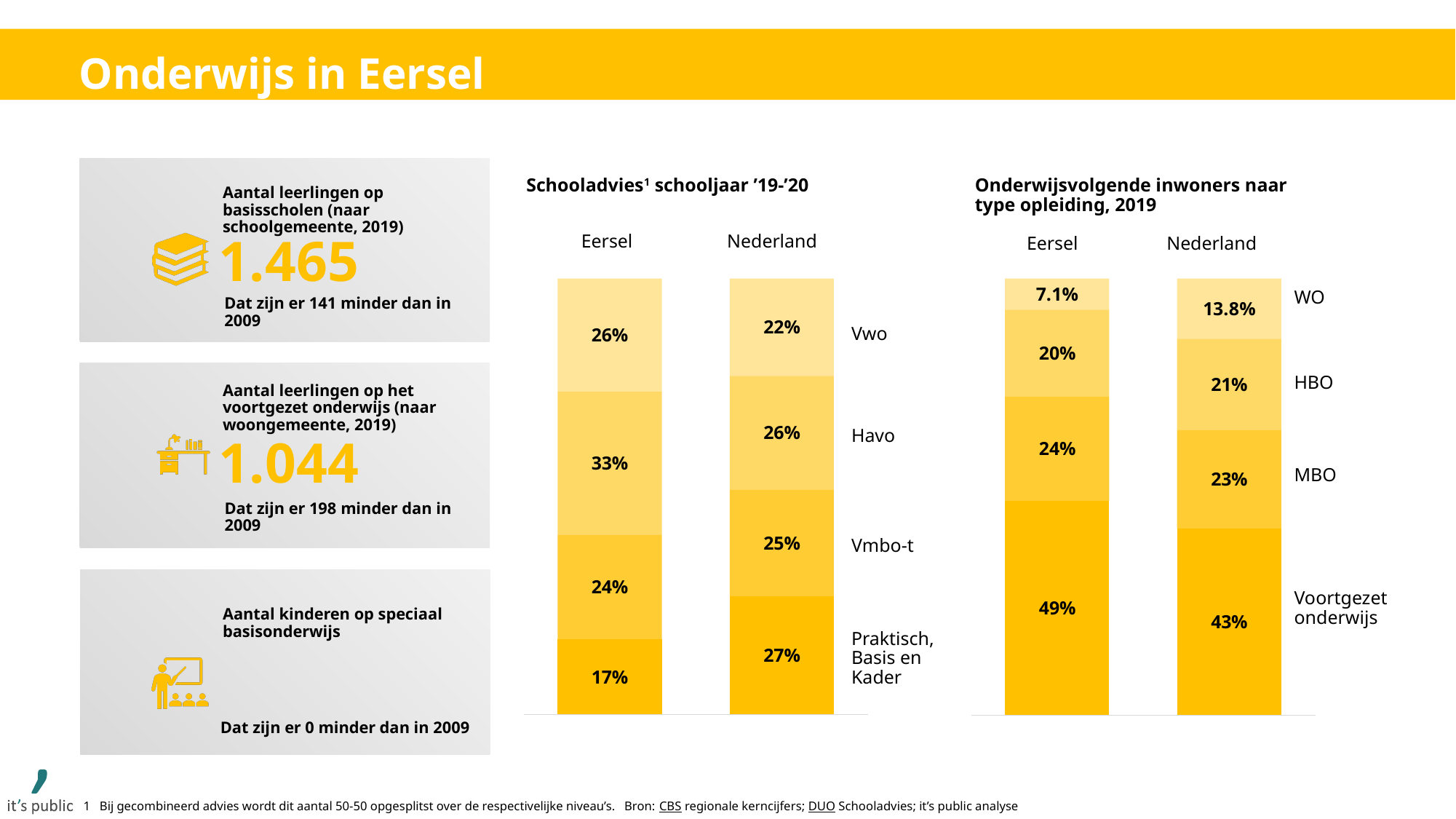
In the 'Onderwijsvolgende inwoners naar type opleiding, 2019' chart, what percentage of the Nederland bar is MBO? 23% In the 'Schooladvies schooljaar '19-'20' chart, which has a larger Praktisch, Basis en Kader share: Eersel or Nederland? Nederland In the 'Schooladvies schooljaar '19-'20' chart, which segment is the smallest in the Eersel bar? Praktisch, Basis en Kader In the 'Onderwijsvolgende inwoners naar type opleiding, 2019' chart, what percentage of the Eersel bar is WO? 7.1% In the 'Onderwijsvolgende inwoners naar type opleiding, 2019' chart, which segment is the largest in the Nederland bar? Voortgezet onderwijs In the 'Schooladvies schooljaar '19-'20' chart, which segment is the largest in the Eersel bar? Havo How many segments does each bar have in the 'Onderwijsvolgende inwoners naar type opleiding, 2019' chart? 4 In the 'Onderwijsvolgende inwoners naar type opleiding, 2019' chart, what is the difference between the Voortgezet onderwijs share for Eersel and for Nederland? 6 percentage points In the 'Schooladvies schooljaar '19-'20' chart, what is the difference between the Vwo share for Eersel and for Nederland? 4 percentage points What kind of chart is the 'Schooladvies schooljaar '19-'20' chart? Stacked bar chart In the 'Schooladvies schooljaar '19-'20' chart, what percentage of the Nederland bar is Praktisch, Basis en Kader? 27% In the 'Schooladvies schooljaar '19-'20' chart, what percentage of the Eersel bar is Havo? 33%